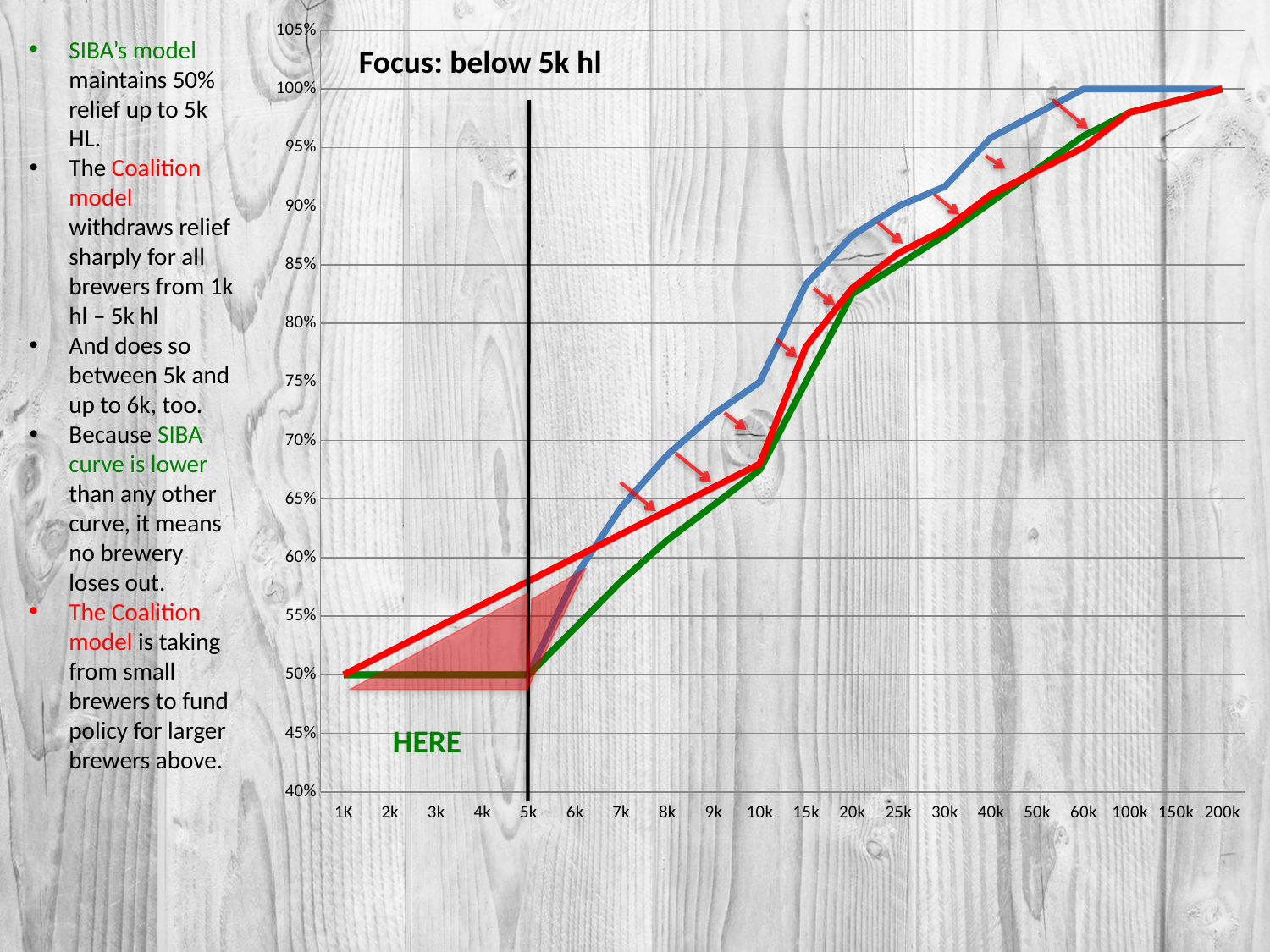
What value do the lines reach at 200k? 100% At 8k, which line is higher, the red line or the green line? red line How many lines are plotted on the chart? 3 Is the value of the green line at 10k greater or less than 70%? less Is the value of the green line at 20k greater or less than 80%? greater At 8k, which line is higher, the blue line or the red line? blue line How many categories are labelled on the x axis of the chart? 20 Is the value of the red line at 5k greater or less than 55%? greater Do the values of the lines rise or fall as the x axis moves from 1K to 200k? rise What is the title of the chart? Focus: below 5k hl What value does the green line have at 5k? 50% What kind of chart is shown on the slide? line chart